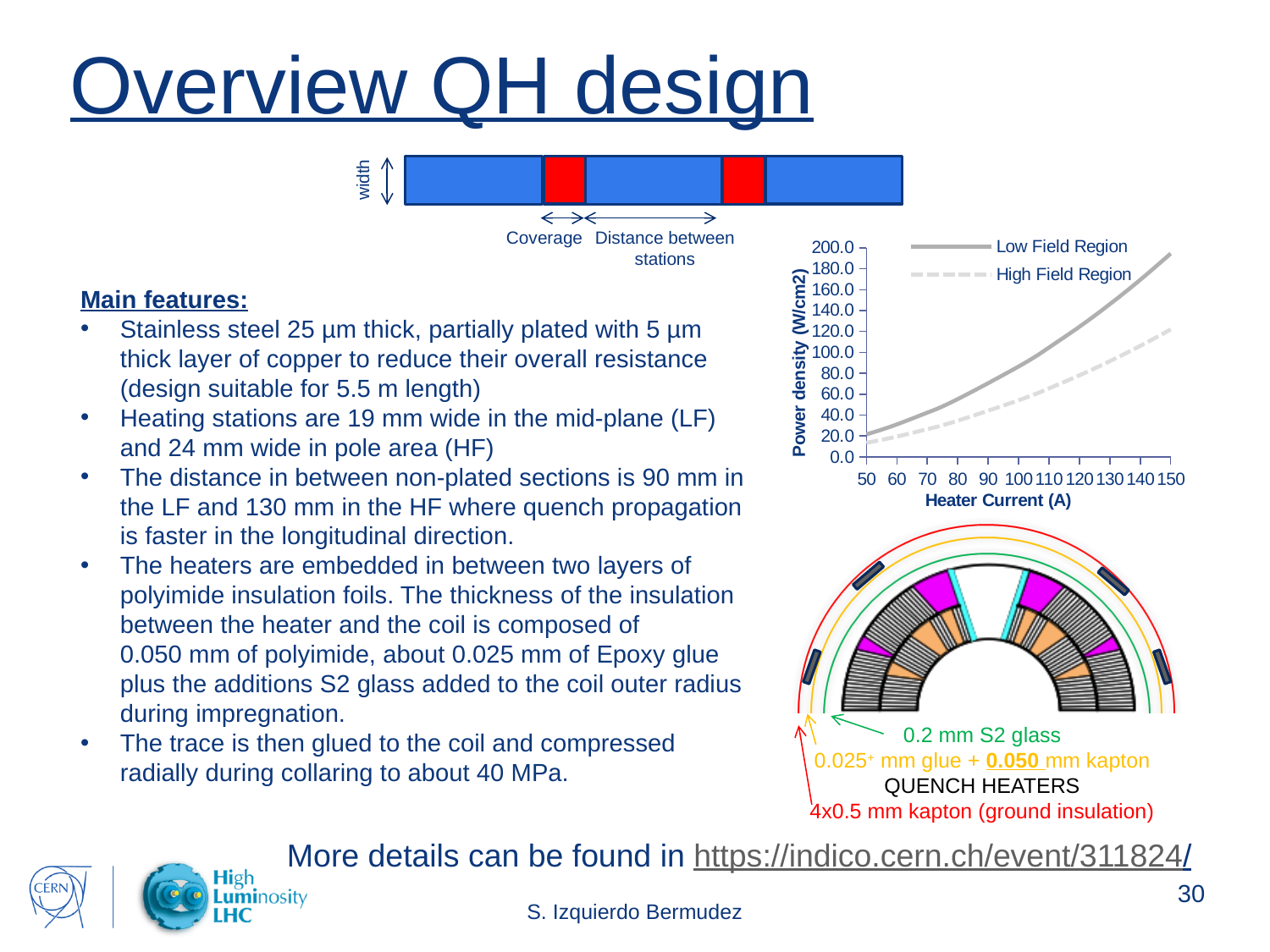
At a heater current of 100 A, which series has the lower power density, Low Field Region or High Field Region? High Field Region How many series does the chart's legend list? 2 What kind of chart is shown on the slide? line chart What is the label of the chart's x axis? Heater Current (A) Does the power density for the Low Field Region rise or fall as heater current increases? rise Is the power density for the Low Field Region at 150 A greater or less than 160.0 W/cm2? greater At a heater current of 150 A, which series has the higher power density, Low Field Region or High Field Region? Low Field Region Does the power density for the High Field Region rise or fall as heater current increases? rise What are the two series named in the chart's legend? Low Field Region and High Field Region Is the power density for the High Field Region at 150 A greater or less than 160.0 W/cm2? less Is the power density for the Low Field Region at 50 A greater or less than 40.0 W/cm2? less